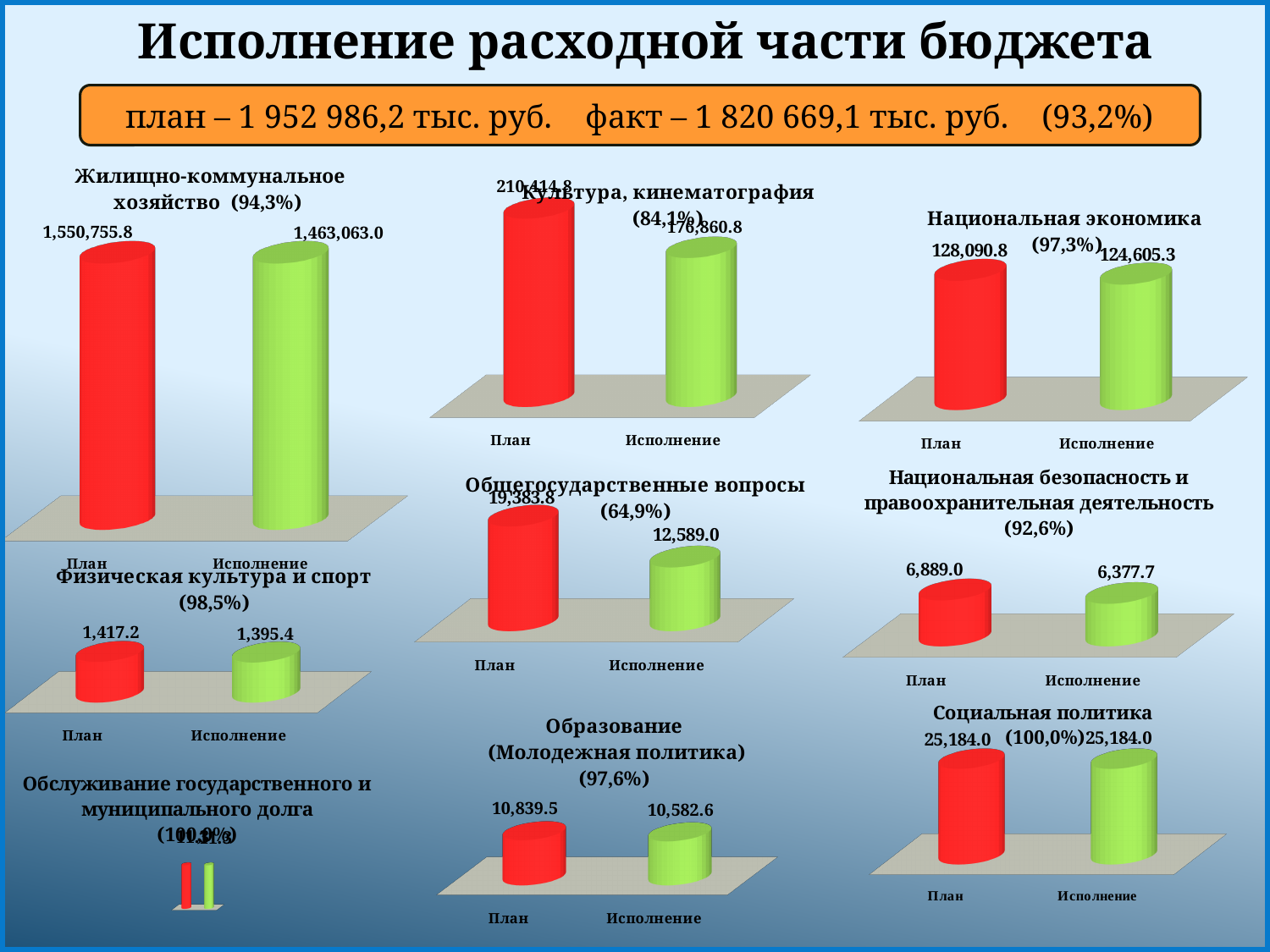
In the chart titled "Образование (Молодежная политика)", what is the difference between План and Исполнение? 256.9 In the chart titled "Социальная политика", what is the value for Исполнение? 25,184.0 In the chart titled "Общегосударственные вопросы", what is the difference between План and Исполнение? 6,794.8 In the chart titled "Физическая культура и спорт", what is the value for Исполнение? 1,395.4 In the chart titled "Жилищно-коммунальное хозяйство", what is the value for План? 1,550,755.8 What kind of chart is the one titled "Социальная политика"? bar chart In the chart titled "Жилищно-коммунальное хозяйство", what is the value for Исполнение? 1,463,063.0 How many bars does the chart titled "Национальная экономика" have? 2 In the chart titled "Национальная безопасность и правоохранительная деятельность", what is the value for План? 6,889.0 In the chart titled "Национальная экономика", what is the value for Исполнение? 124,605.3 In the chart titled "Культура, кинематография", what is the value for План? 210,414.8 In the chart titled "Общегосударственные вопросы", which bar is higher, План or Исполнение? План